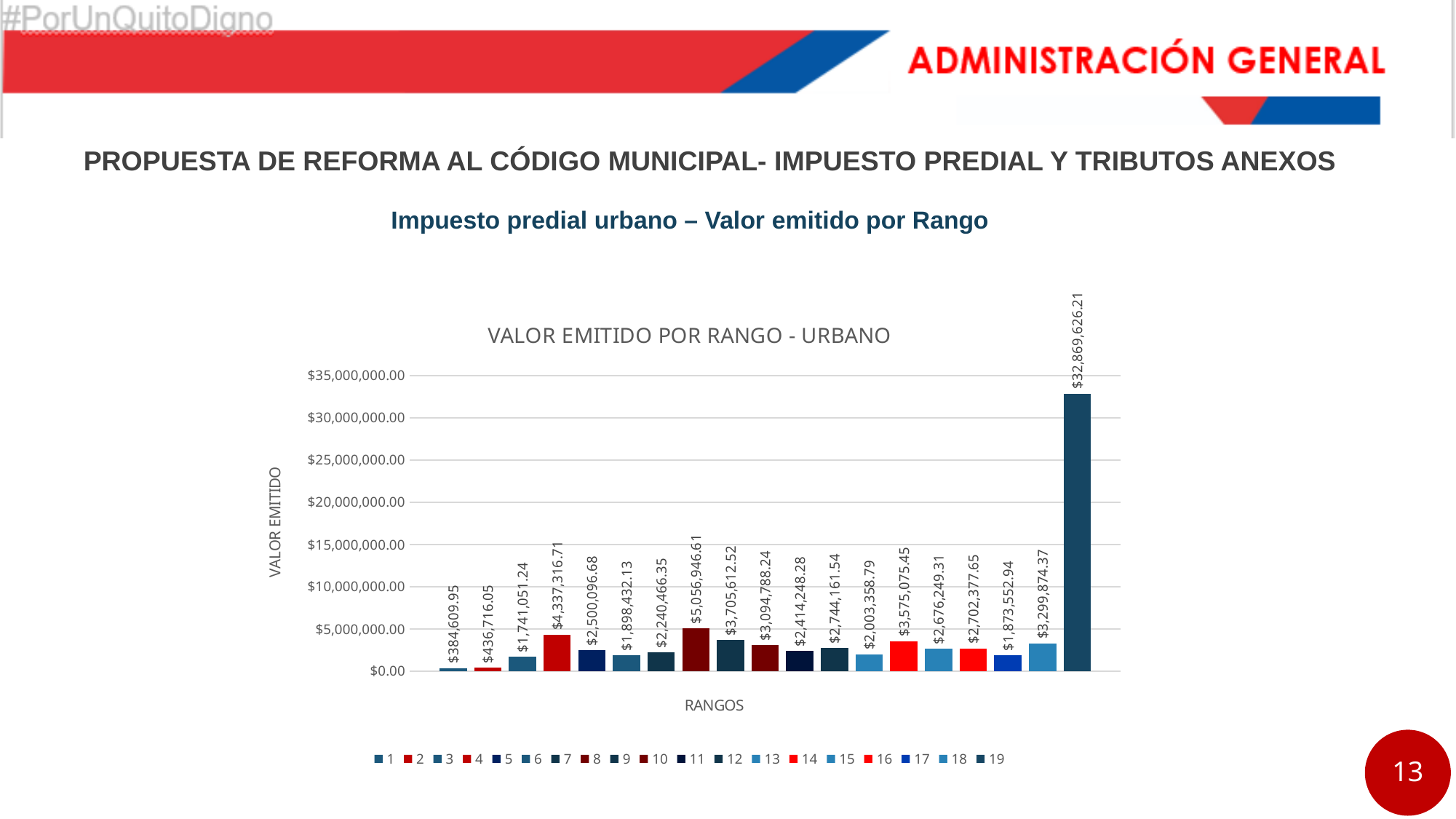
Is the value for rango 19 greater or less than $30,000,000.00? greater How many bars (rangos) are plotted in the chart? 19 What is the value emitted for rango 1? $384,609.95 What is the title of the chart? VALOR EMITIDO POR RANGO - URBANO What is the value emitted for rango 8? $5,056,946.61 What is the difference between the values for rango 19 and rango 8? $27,812,679.60 What type of chart is shown on the slide? bar chart Which rango has the lowest value emitted? 1 Which rango has the highest value emitted? 19 How many entries does the legend list? 19 What is the value emitted for rango 19? $32,869,626.21 Which has a larger value emitted, rango 12 or rango 13? rango 12